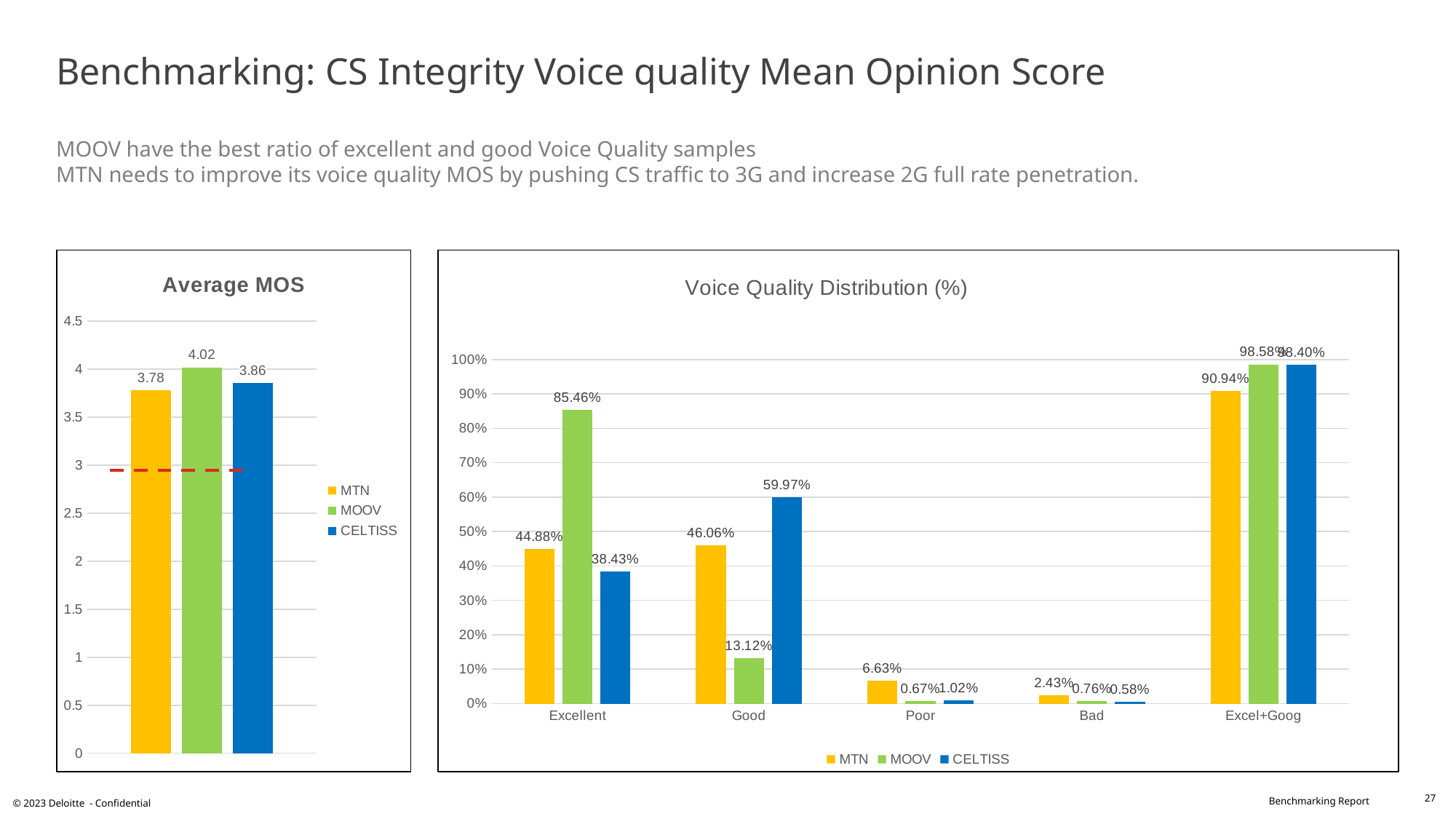
In the Voice Quality Distribution (%) chart, which is larger in the Bad category: MOOV or CELTISS? MOOV What type of chart is the Voice Quality Distribution (%) chart? Bar chart In the Voice Quality Distribution (%) chart, is the MTN value for Excellent greater or less than 50%? less In the Average MOS chart, how many series does the legend list? 3 In the Average MOS chart, what is the value for MOOV? 4.02 In the Voice Quality Distribution (%) chart, what is the difference between the MTN and MOOV values in the Good category? 32.94% In the Average MOS chart, which operator has the lowest average MOS? MTN In the Average MOS chart, what is the difference between the MOOV and MTN values? 0.24 In the Voice Quality Distribution (%) chart, what is the value for MOOV in the Excellent category? 85.46% In the Voice Quality Distribution (%) chart, what is the value for CELTISS in the Good category? 59.97% How many categories are shown on the x axis of the Voice Quality Distribution (%) chart? 5 In the Voice Quality Distribution (%) chart, which operator has the highest value in the Poor category? MTN